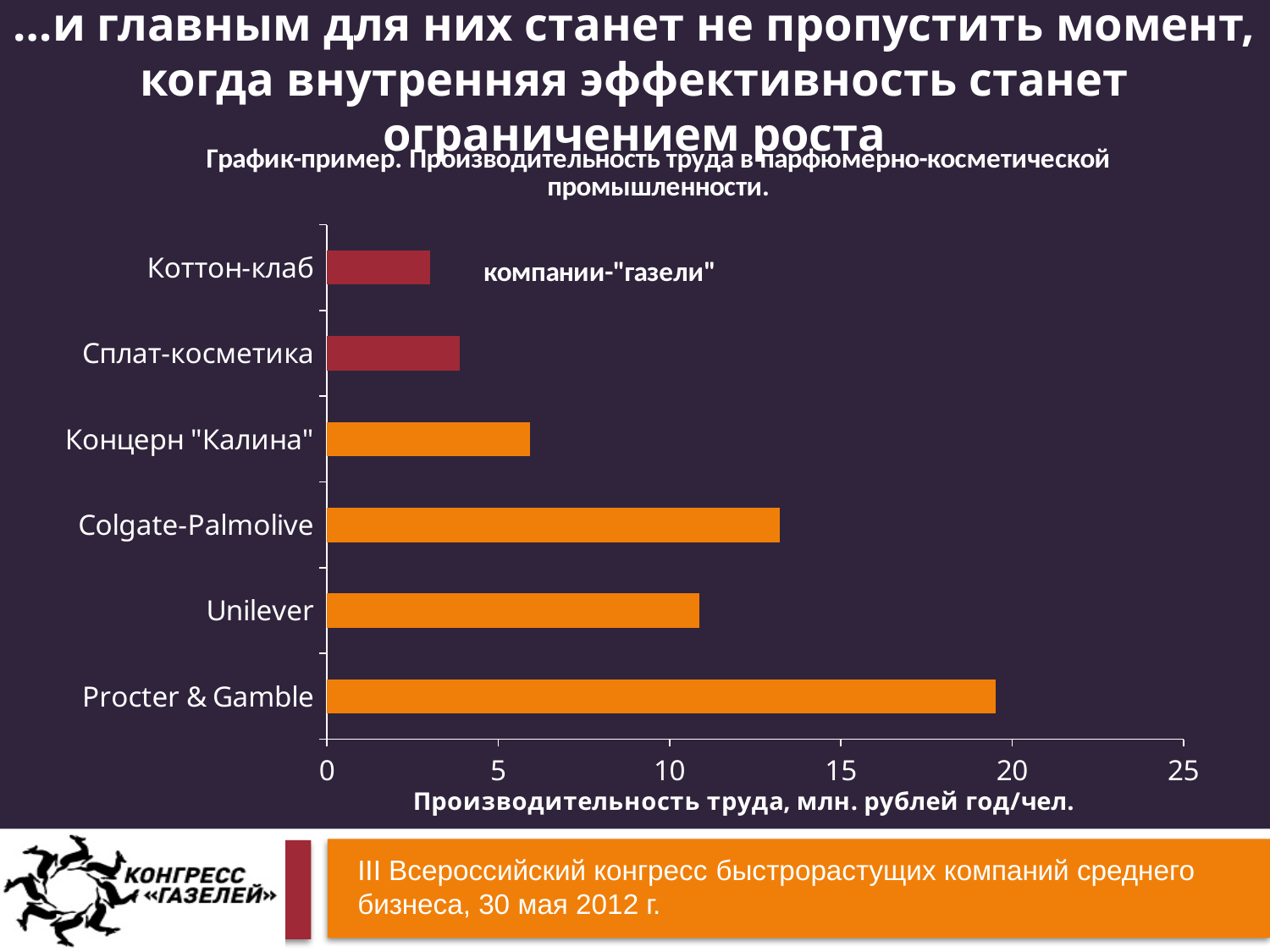
Is the value for Коттон-клаб greater or less than 5? less Which company has the lowest labour productivity in the chart? Коттон-клаб Which has the larger value, Концерн "Калина" or Сплат-косметика? Концерн "Калина" Is the value for Colgate-Palmolive greater or less than 10? greater Which company has the highest labour productivity in the chart? Procter & Gamble What kind of chart is shown on the slide? bar chart What is the title of the horizontal axis of the chart? Производительность труда, млн. рублей год/чел. What label is written next to the red bars at the top of the chart? компании-"газели" Which has the larger value, Colgate-Palmolive or Unilever? Colgate-Palmolive Is the value for Unilever greater or less than 15? less How many companies are shown in the chart? 6